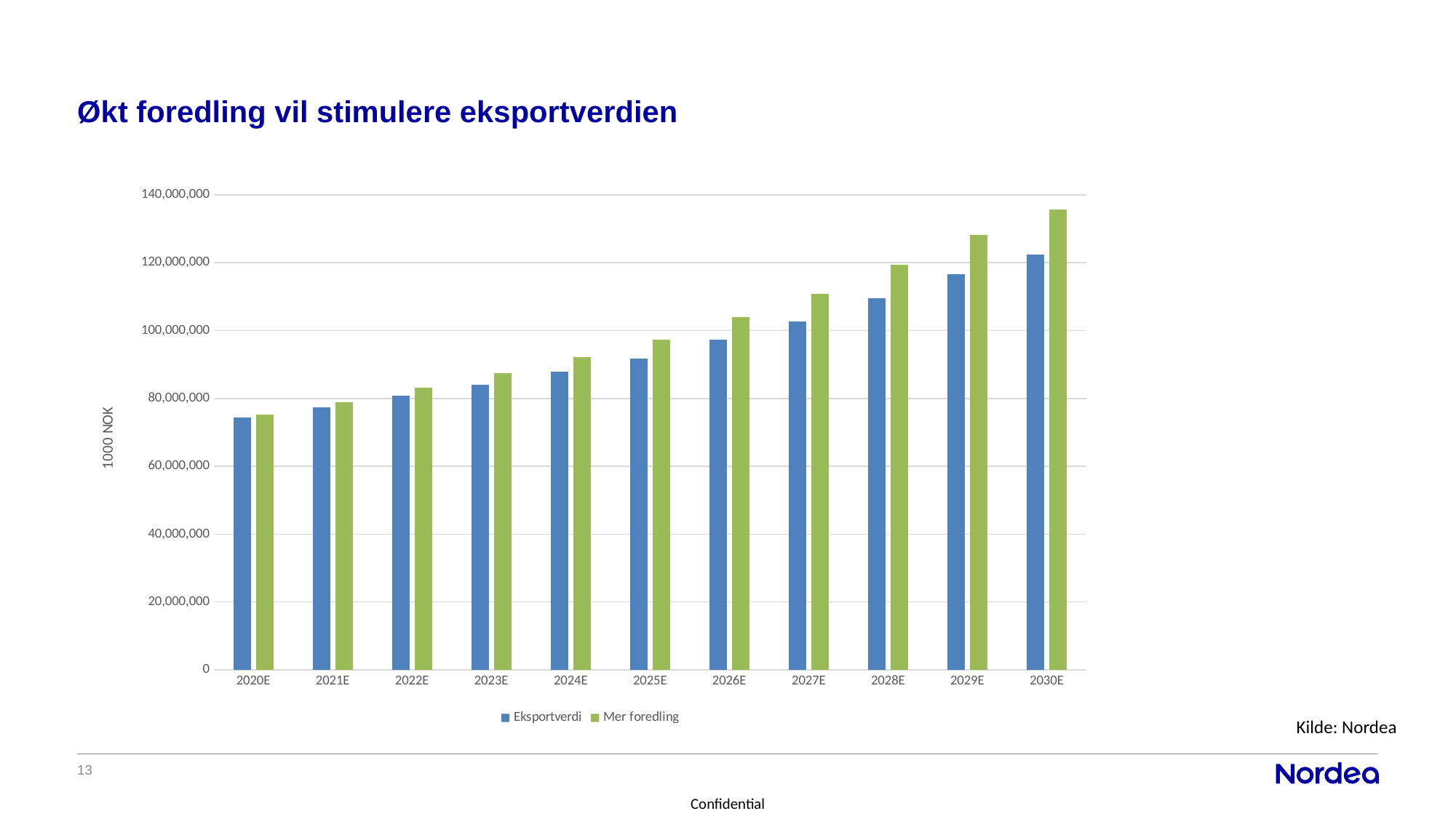
In 2030E, which is larger: Eksportverdi or Mer foredling? Mer foredling Is the value for Eksportverdi in 2024E greater or less than 80,000,000? greater Is the value for Mer foredling in 2027E greater or less than 100,000,000? greater How many series does the legend list? 2 Is the value for Eksportverdi in 2020E greater or less than 80,000,000? less What is the label on the y axis? 1000 NOK How many years are shown on the x axis? 11 Do the Eksportverdi values rise or fall from 2020E to 2030E? Rise What kind of chart is shown on the slide? Bar chart Which year has the lowest value for Eksportverdi? 2020E Which year has the highest value for Mer foredling? 2030E